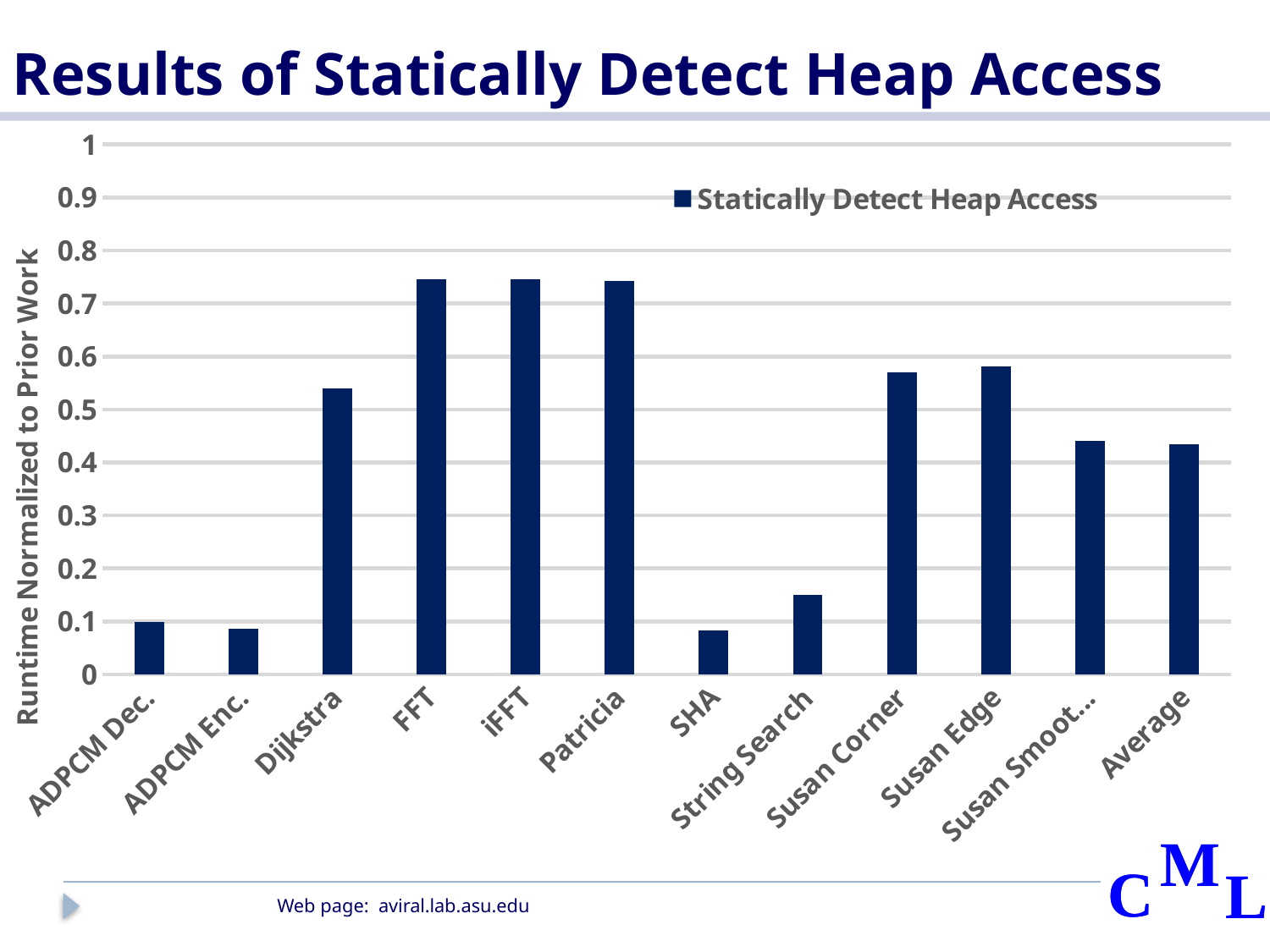
Which has the larger value, Dijkstra or String Search? Dijkstra Is the value for Average greater or less than 0.5? less How many series does the legend list? 1 What kind of chart is shown on the slide? bar chart Is the value for Susan Edge greater or less than 0.6? less Which has the larger value, Average or Patricia? Patricia What is the series name shown in the legend? Statically Detect Heap Access Is the value for SHA greater or less than 0.1? less How many categories are plotted along the x axis? 12 What is the title of the y axis? Runtime Normalized to Prior Work